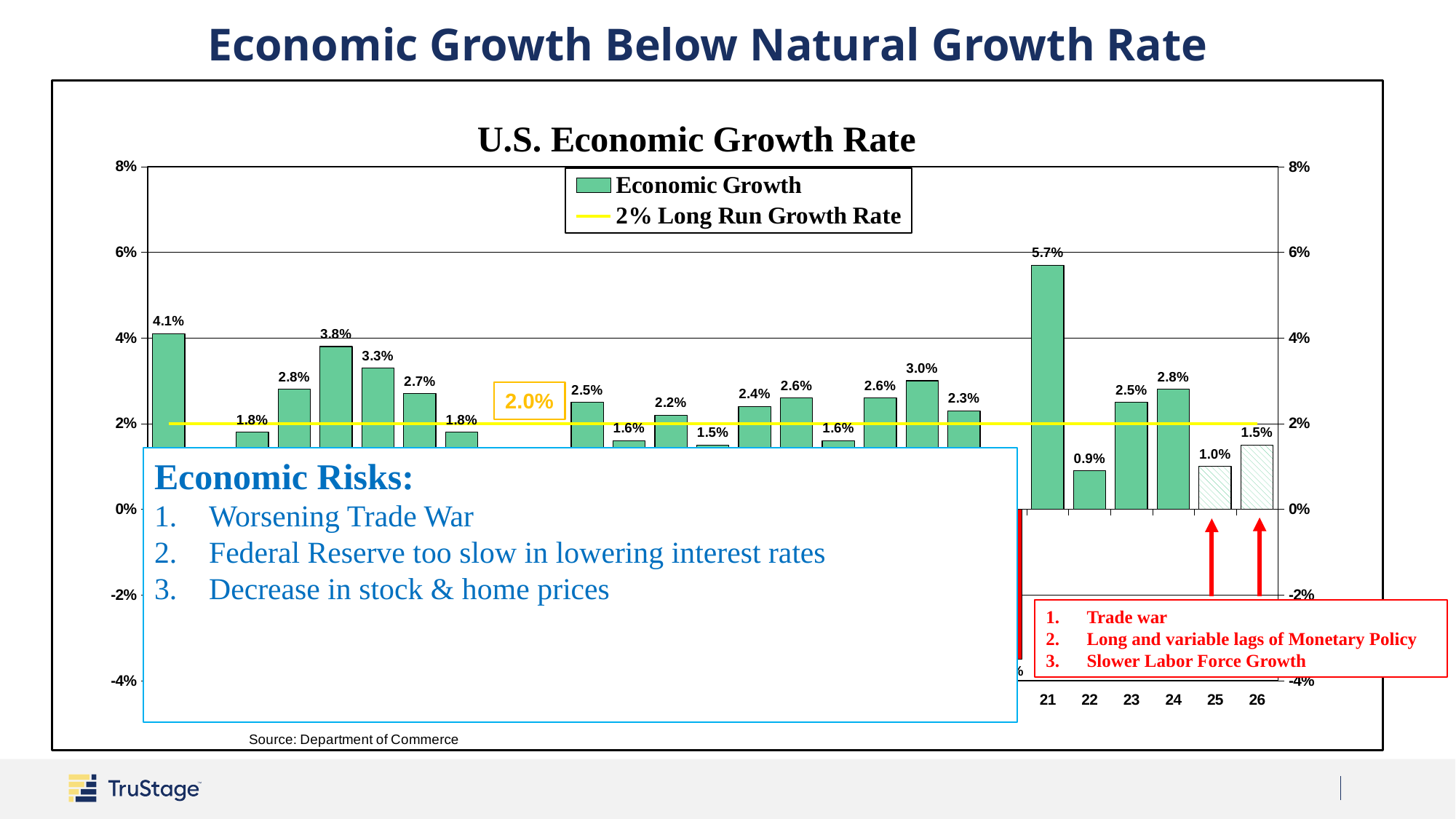
How many series does the legend list? 2 What is the projected economic growth rate for 26? 1.5% What value is labeled on the bar for 24? 2.8% Is the value for 22 greater or less than 2%? less Which has a higher economic growth rate, 23 or 26? 23 What kind of chart is used to show the economic growth data? bar chart Among the years 21 through 26, which has the lowest economic growth rate? 22 What is the difference between the growth rates for 24 and 25? 1.8% What is the economic growth rate for 21 in the U.S. Economic Growth Rate chart? 5.7% What is the title of the chart? U.S. Economic Growth Rate Which year has the highest economic growth rate in the chart? 21 What is the economic growth rate shown for 22? 0.9%